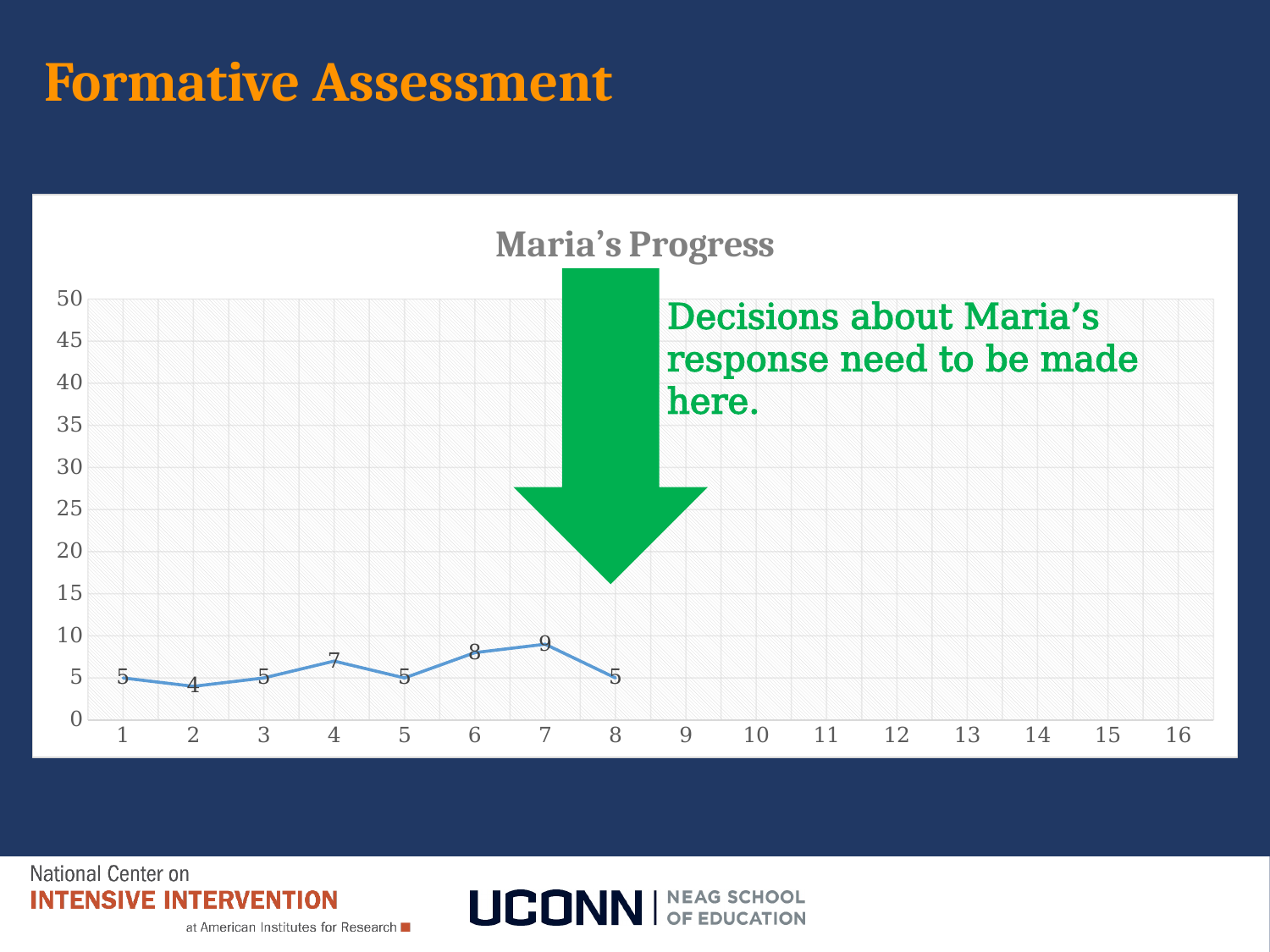
How many data points are plotted on the line? 8 What is the difference between the values at point 7 and point 2? 5 What is the value plotted at point 8? 5 What is the value plotted at point 4? 7 At which x-axis point is the plotted value highest? 7 What is the value plotted at point 7? 9 What is the value plotted at point 1? 5 Is the value at point 7 greater or less than 10? less Which is larger, the value at point 6 or the value at point 5? point 6 What kind of chart is shown on the slide? line chart What is the title of the chart? Maria's Progress At which x-axis point is the plotted value lowest? 2